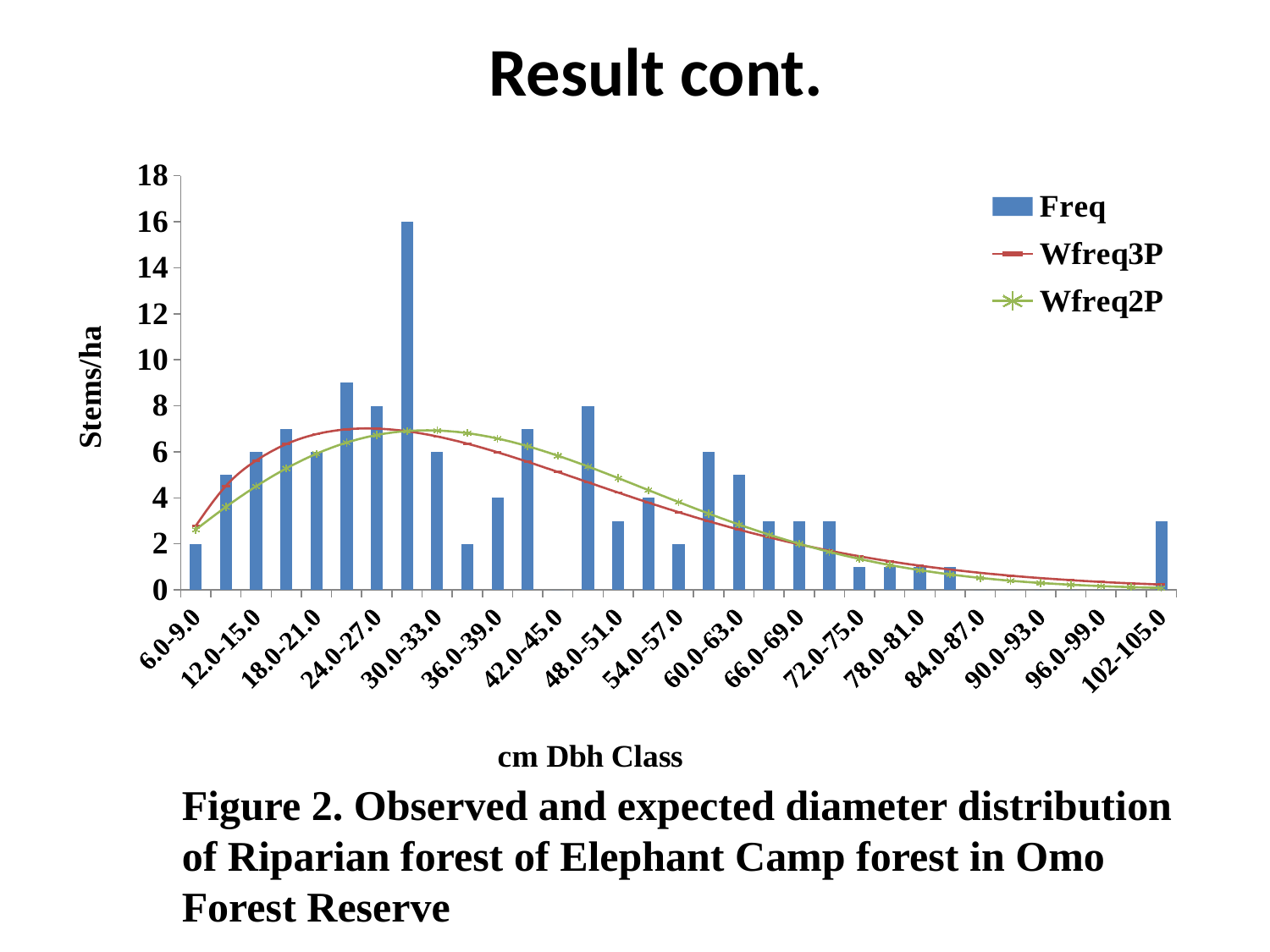
What is the Freq value for the 24.0-27.0 cm Dbh class? 8 What is the Freq value for the 36.0-39.0 cm Dbh class? 4 Is the Freq value for the 48.0-51.0 class greater or less than 4? less Does the Wfreq2P line rise or fall from the 30.0-33.0 class to the 96.0-99.0 class? fall What is the difference between the Freq values for the 24.0-27.0 class and the 6.0-9.0 class? 6 What is the Freq value for the 54.0-57.0 cm Dbh class? 2 What kind of chart is shown on the slide? combination bar and line chart What is the Freq value for the 6.0-9.0 cm Dbh class? 2 What is the label of the vertical axis? Stems/ha Which has the larger Freq value, the 24.0-27.0 class or the 30.0-33.0 class? 24.0-27.0 How many series does the legend list? 3 What is the Freq value for the 12.0-15.0 cm Dbh class? 6